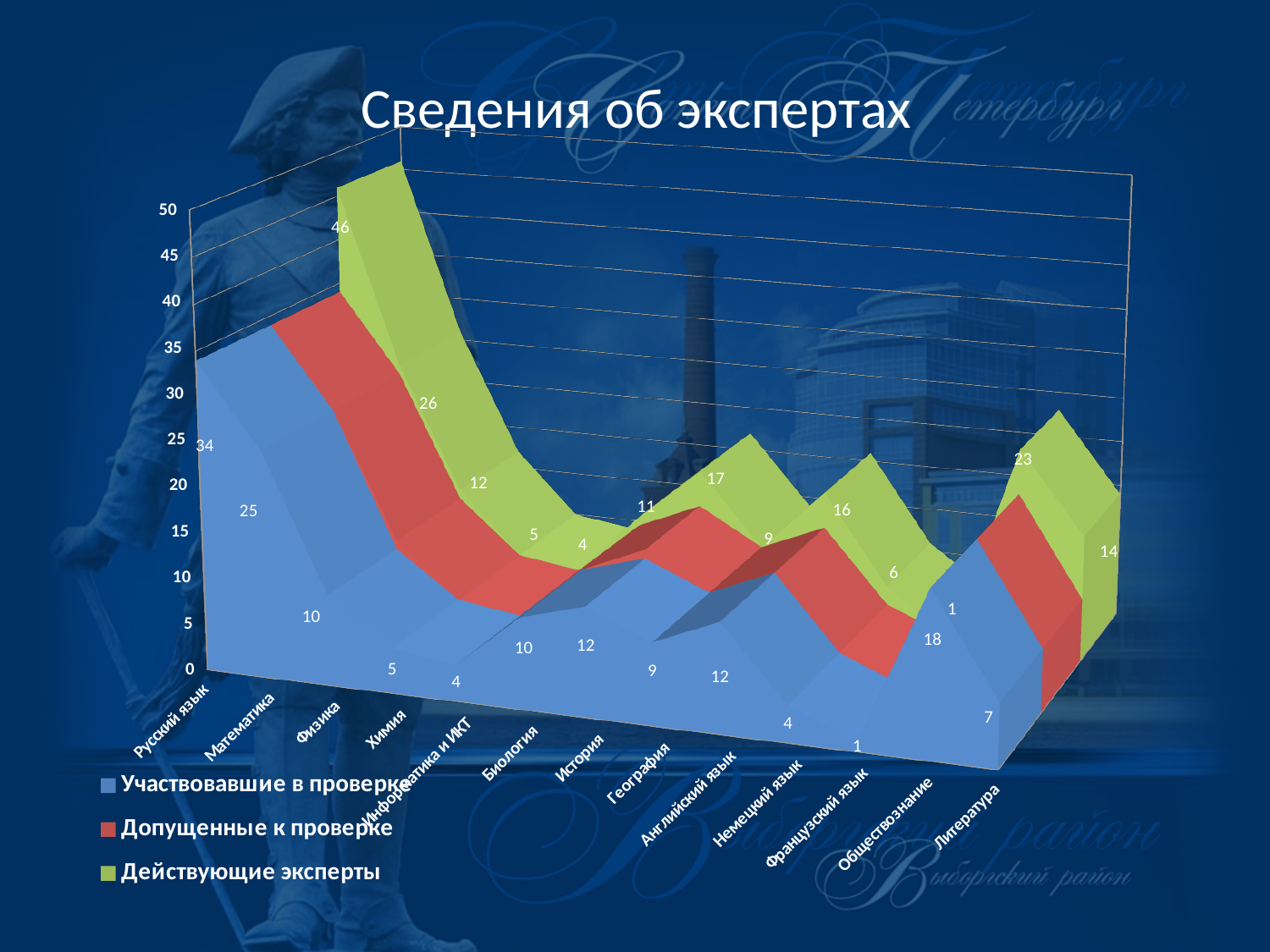
Which series is shown in green in the legend? Действующие эксперты What is the difference between Действующие эксперты and Участвовавшие в проверке for Русский язык? 12 What is the value of Участвовавшие в проверке for Русский язык? 34 What is the title of the chart? Сведения об экспертах What is the value of Действующие эксперты for Русский язык? 46 What is the value of Участвовавшие в проверке for Математика? 25 Is the value of Действующие эксперты for Русский язык greater or less than 40? greater Which subject has the highest value for Действующие эксперты? Русский язык What kind of chart is shown on the slide? area chart How many subject categories are plotted along the x axis? 13 Do the values of Участвовавшие в проверке rise or fall from Русский язык to Информатика и ИКТ? fall How many series does the legend list? 3